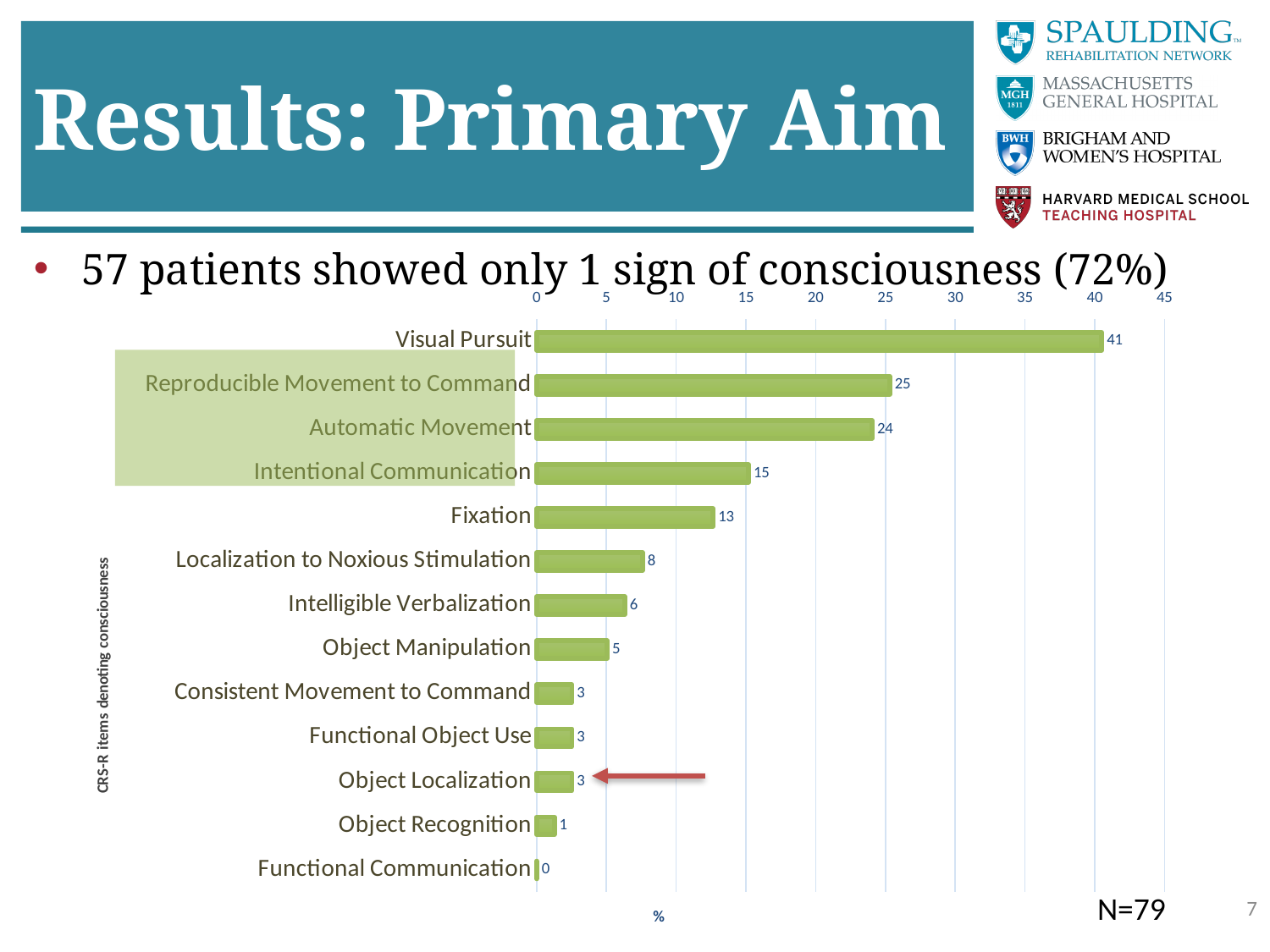
What is the value for Visual Pursuit? 41 What is the value for Fixation? 13 Is the value for Reproducible Movement to Command greater or less than 20? greater What is the value for Automatic Movement? 24 What is the value for Object Recognition? 1 Which is larger, the value for Intentional Communication or the value for Fixation? Intentional Communication What kind of chart is shown on the slide? bar chart What is the difference between the values for Visual Pursuit and Reproducible Movement to Command? 16 Which CRS-R item has the lowest value? Functional Communication How many CRS-R items are plotted in the chart? 13 Which CRS-R item has the highest value? Visual Pursuit What is the label of the horizontal axis? %